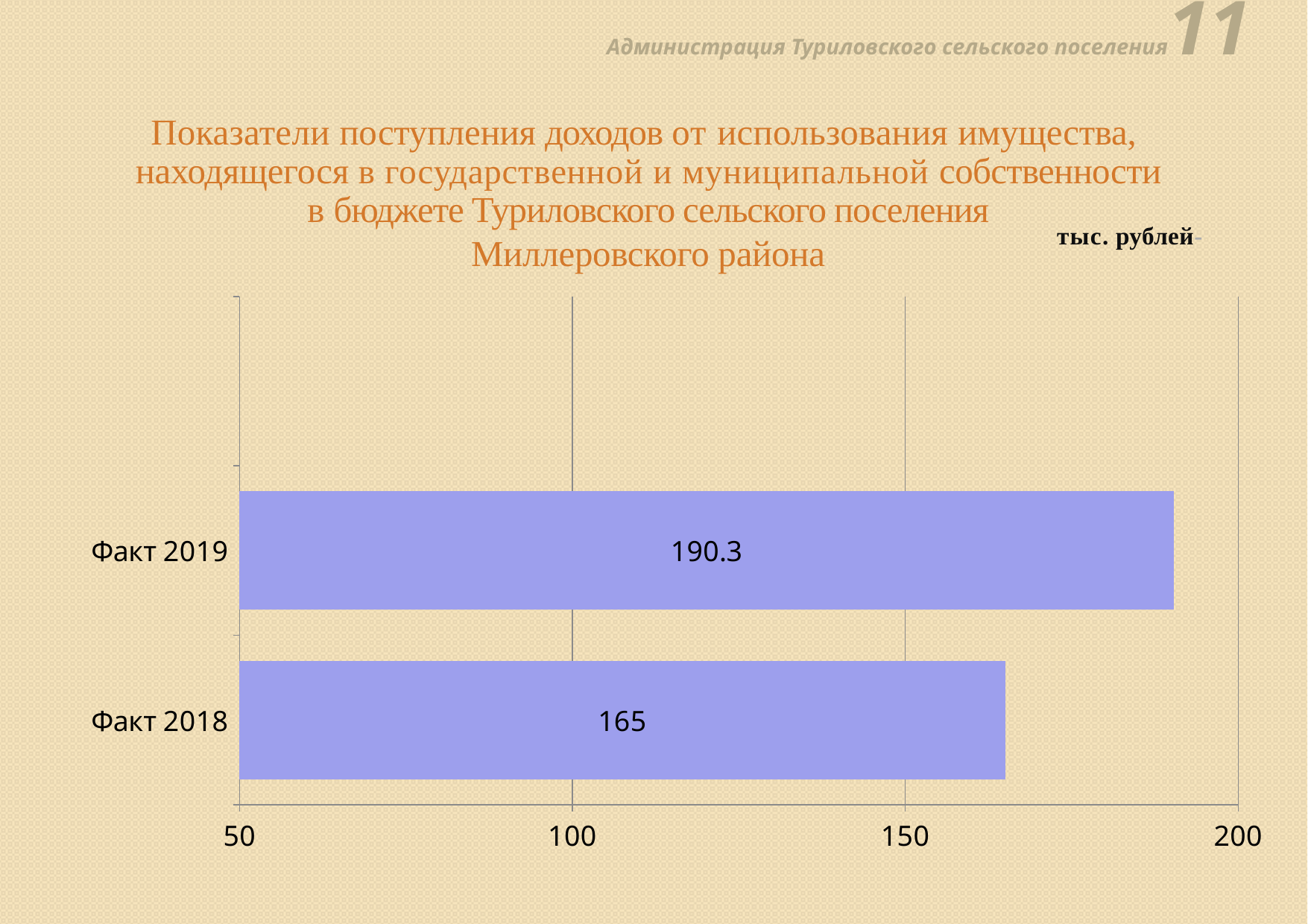
What is the value for Факт 2019? 190.3 Did the value rise or fall from Факт 2018 to Факт 2019? rise Is the value for Факт 2019 greater or less than 200? less What kind of chart is shown on the slide? bar chart Is the value for Факт 2018 greater or less than 150? greater Which category has the highest value? Факт 2019 In what units are the values on the chart expressed? тыс. рублей Which category has the lowest value? Факт 2018 Which is larger, the value for Факт 2018 or the value for Факт 2019? Факт 2019 How many categories are shown in the chart? 2 What is the value for Факт 2018? 165 What is the difference between the values for Факт 2019 and Факт 2018? 25.3